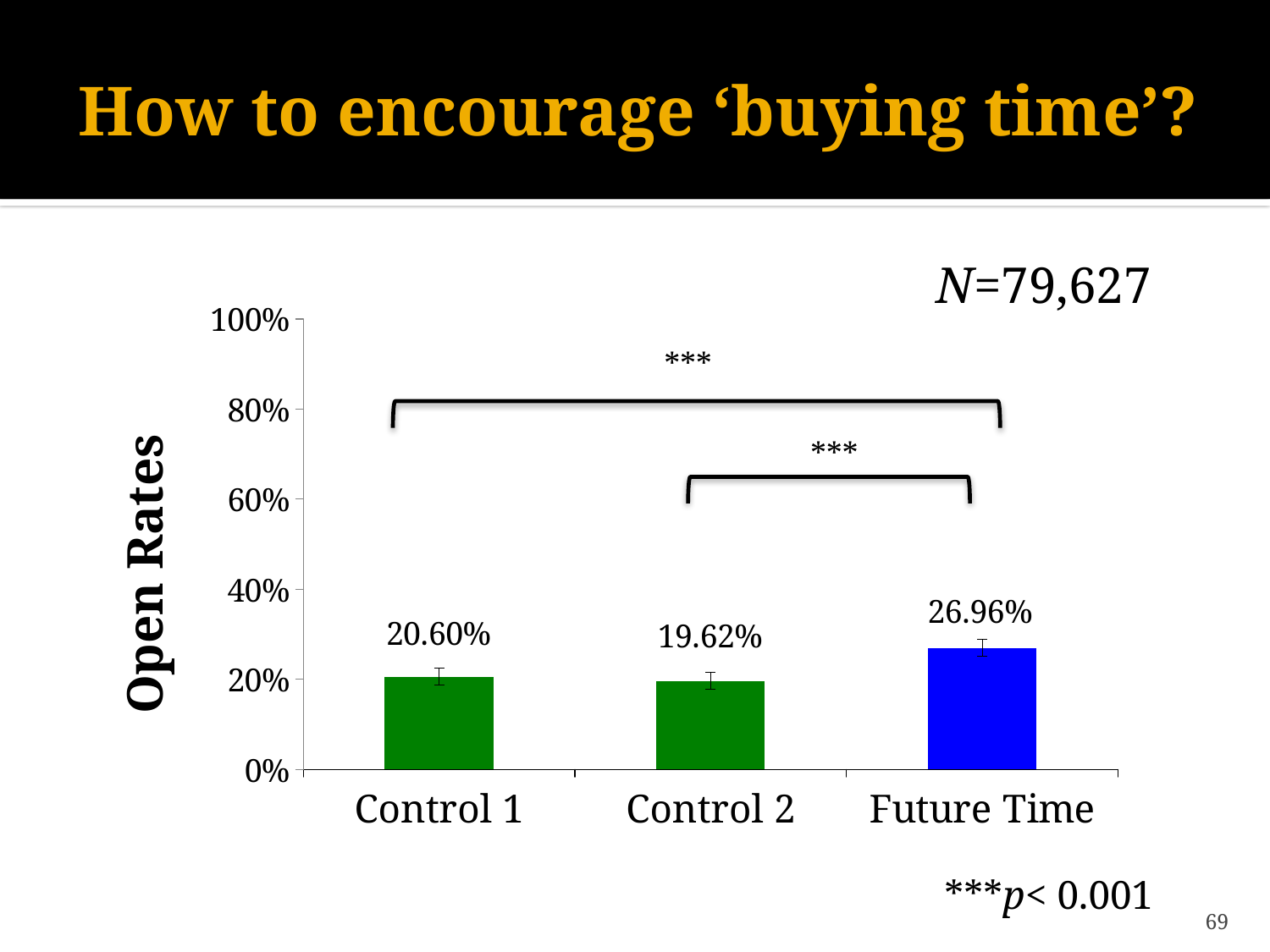
Which has a higher open rate, Control 1 or Future Time? Future Time What is the difference in open rate between Future Time and Control 2? 7.34% What is the open rate for Control 1? 20.60% Which category has the highest open rate? Future Time What is the label of the y axis? Open Rates What is the open rate for Control 2? 19.62% Is the open rate for Future Time greater or less than 40%? less Which category has the lowest open rate? Control 2 What kind of chart is shown on the slide? bar chart What is the difference in open rate between Future Time and Control 1? 6.36% How many categories are shown on the x axis? 3 What is the open rate for Future Time? 26.96%